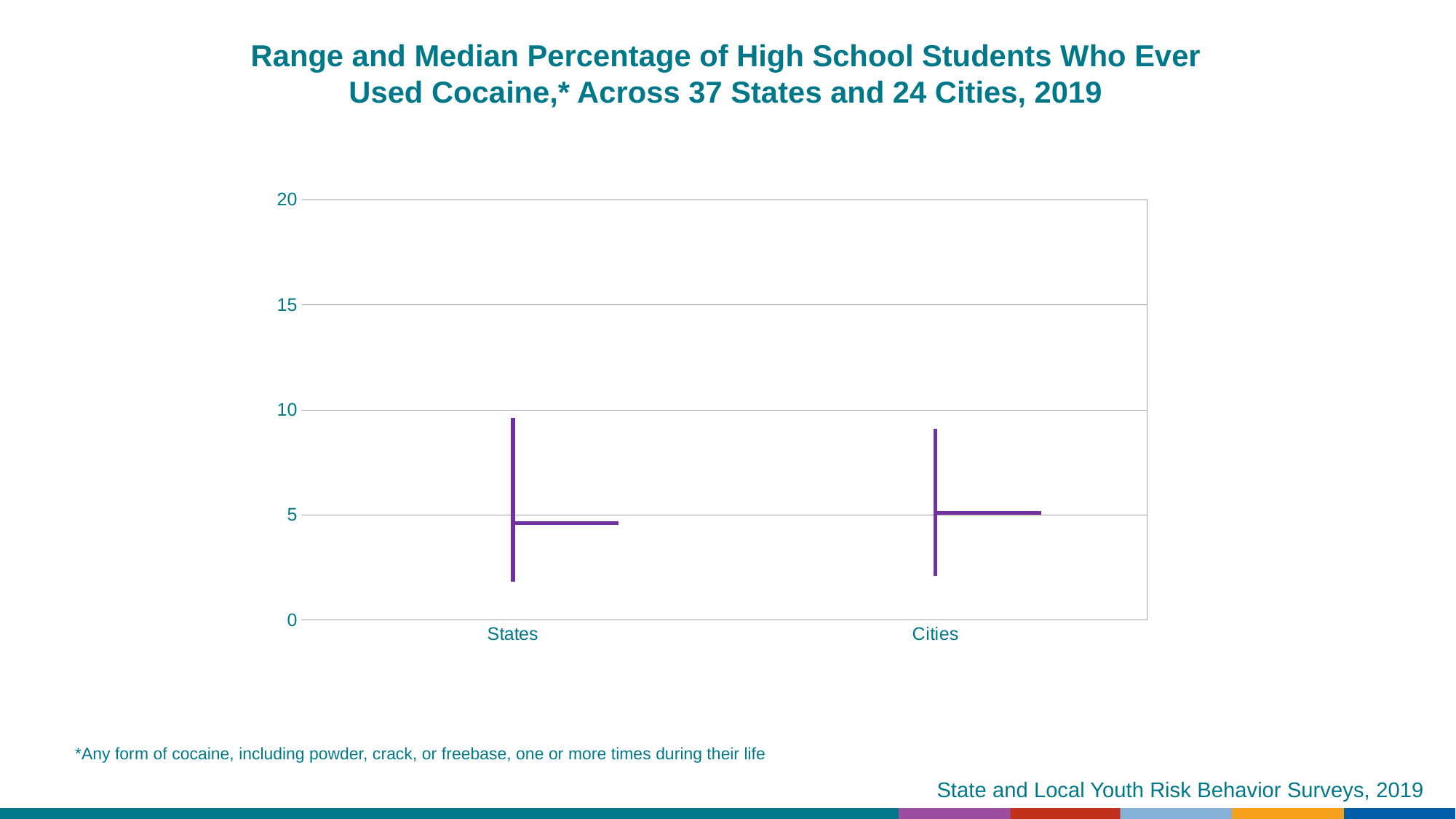
Is the bottom of the range for States greater or less than 5? less How many categories are shown on the x axis of the chart? 2 Is the bottom of the range for Cities greater or less than 5? less What are the two categories shown on the x axis? States and Cities Which category has the higher median, States or Cities? Cities Is the top of the range for Cities greater or less than 10? less Which category has the higher top of its range, States or Cities? States What is the highest value shown on the y axis? 20 What is the title of the chart? Range and Median Percentage of High School Students Who Ever Used Cocaine,* Across 37 States and 24 Cities, 2019